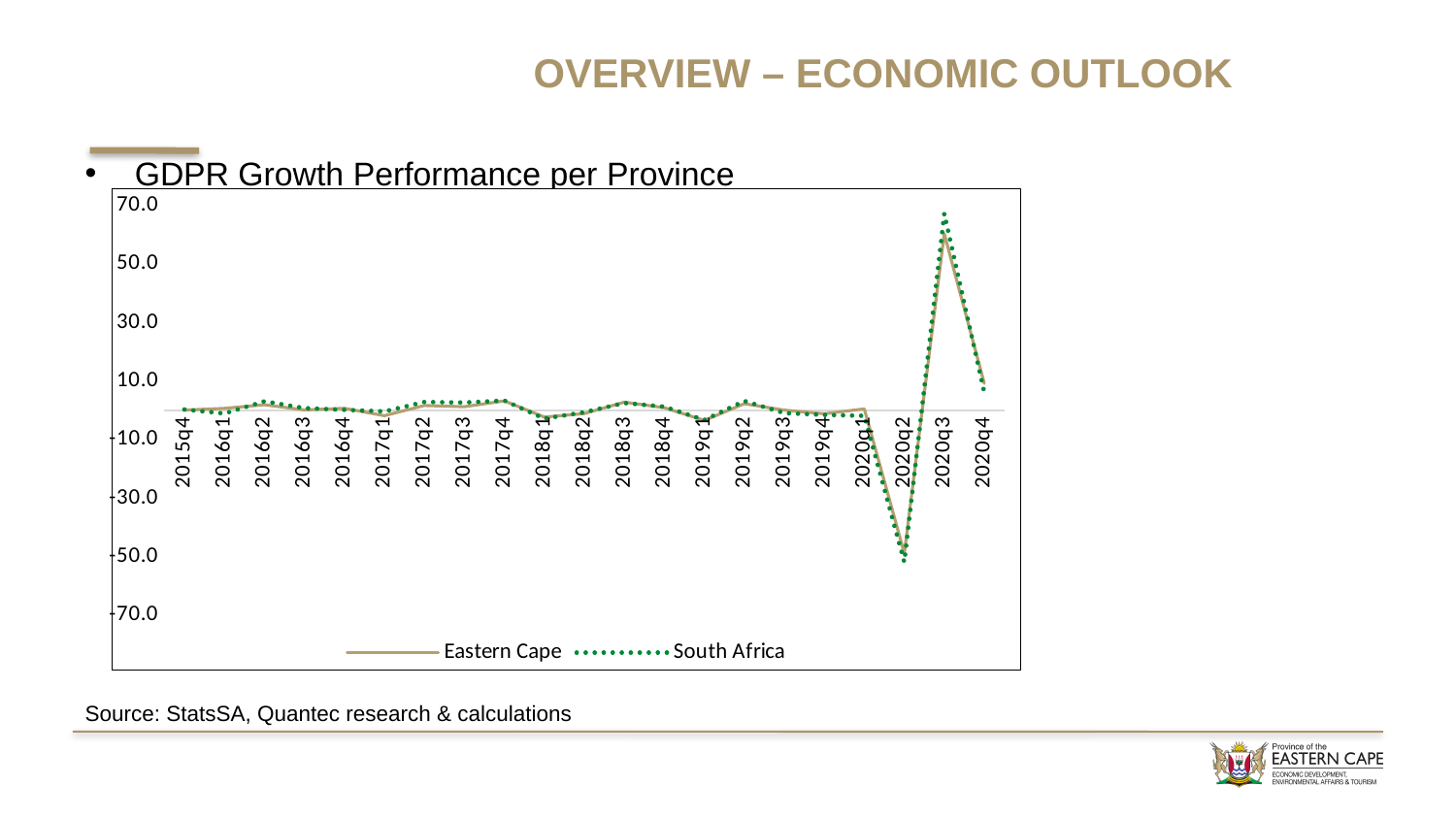
In 2020q3, which series has the higher value, Eastern Cape or South Africa? South Africa Which two series are shown in the legend? Eastern Cape and South Africa How many series does the legend list? 2 Is the South Africa value for 2020q4 greater or less than 10.0? less Is the South Africa value for 2020q3 greater or less than 50.0? greater Is the Eastern Cape value for 2020q2 greater or less than -30.0? less In which quarter does the Eastern Cape series reach its lowest value? 2020q2 What kind of chart is shown on the slide? line chart What is the title of the chart? GDPR Growth Performance per Province Between 2020q2 and 2020q3, do the lines rise or fall? rise In which quarter does the South Africa series reach its highest value? 2020q3 How many quarters are plotted along the x axis? 21